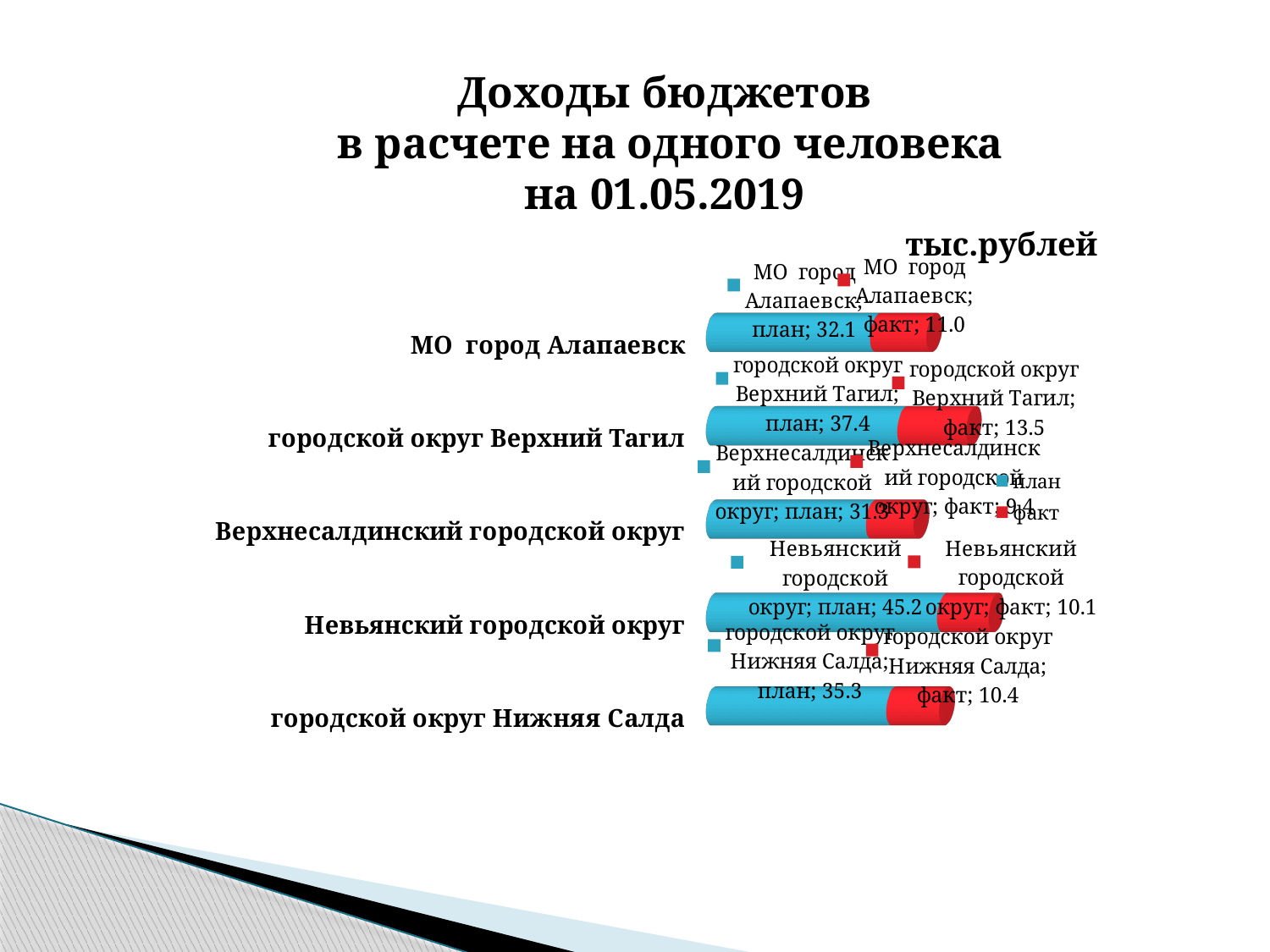
Which category has the lowest факт value? Верхнесалдинский городской округ What is the факт value for городской округ Нижняя Салда? 10.4 How many series does the legend list? 2 What kind of chart is shown on the slide? bar chart What is the total of the stacked bar for городской округ Верхний Тагил? 50.9 Which category has the highest план value? Невьянский городской округ How many categories are shown in the chart? 5 What is the difference between the план and факт values for Верхнесалдинский городской округ? 21.9 What is the план value for МО город Алапаевск? 32.1 Which is larger, the факт value for МО город Алапаевск or the факт value for Невьянский городской округ? МО город Алапаевск What is the план value for Невьянский городской округ? 45.2 What is the факт value for городской округ Верхний Тагил? 13.5